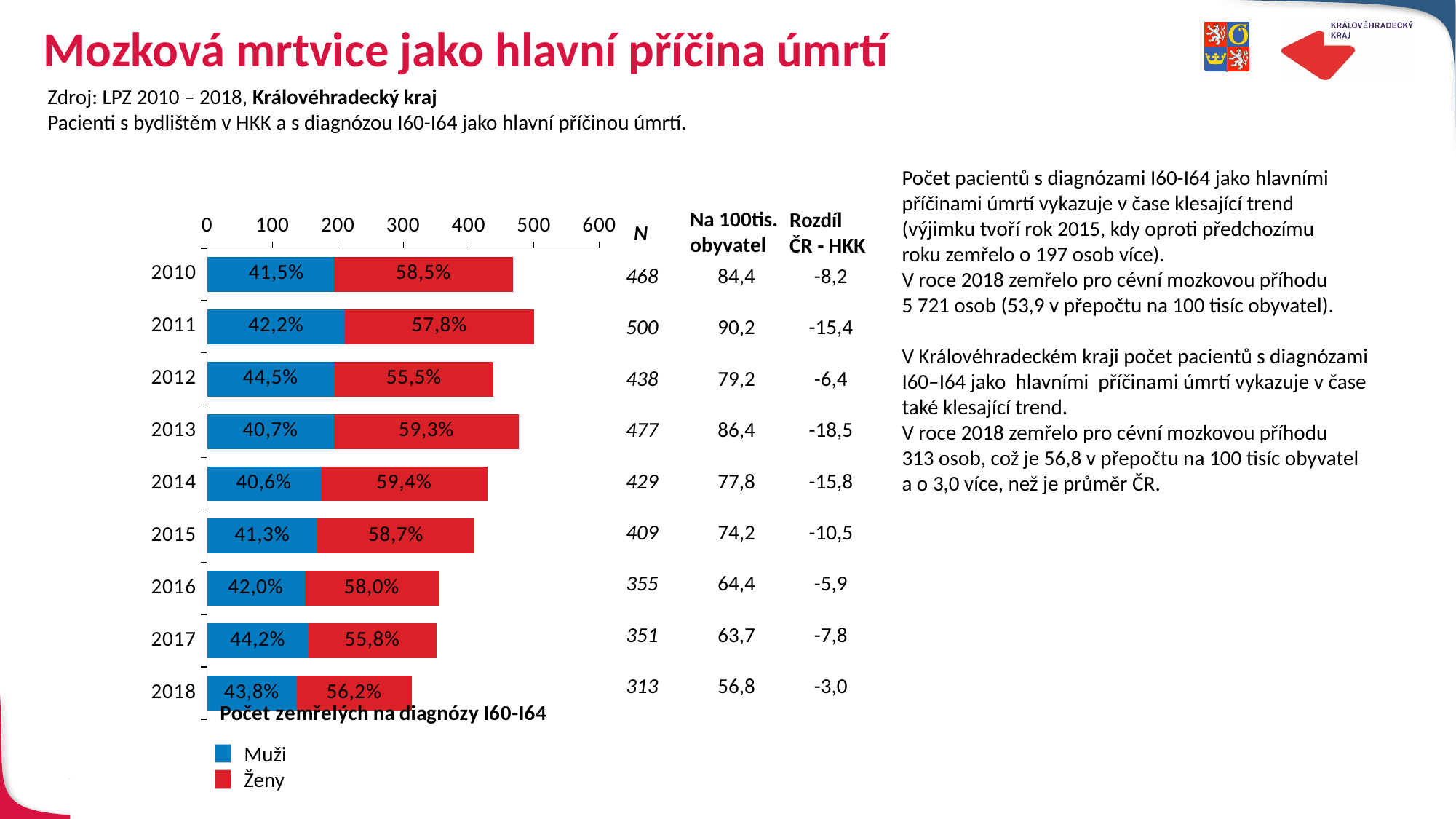
How many years are shown on the chart's vertical axis? 9 Which year has the larger Muži share, 2012 or 2017? 2012 Is the total bar length for 2018 greater or less than 400? less Is the total bar length for 2011 greater or less than 400? greater In which year is the Muži share the lowest? 2014 In which year is the Ženy share the highest? 2014 What is the Ženy share shown for 2018? 56,2% How many series does the chart legend list? 2 What is the Muži share shown for 2010? 41,5% In 2013, by how many percentage points does the Ženy share exceed the Muži share? 18,6 What kind of chart is shown on the slide? Stacked bar chart Which colour represents Muži in the chart legend? Blue